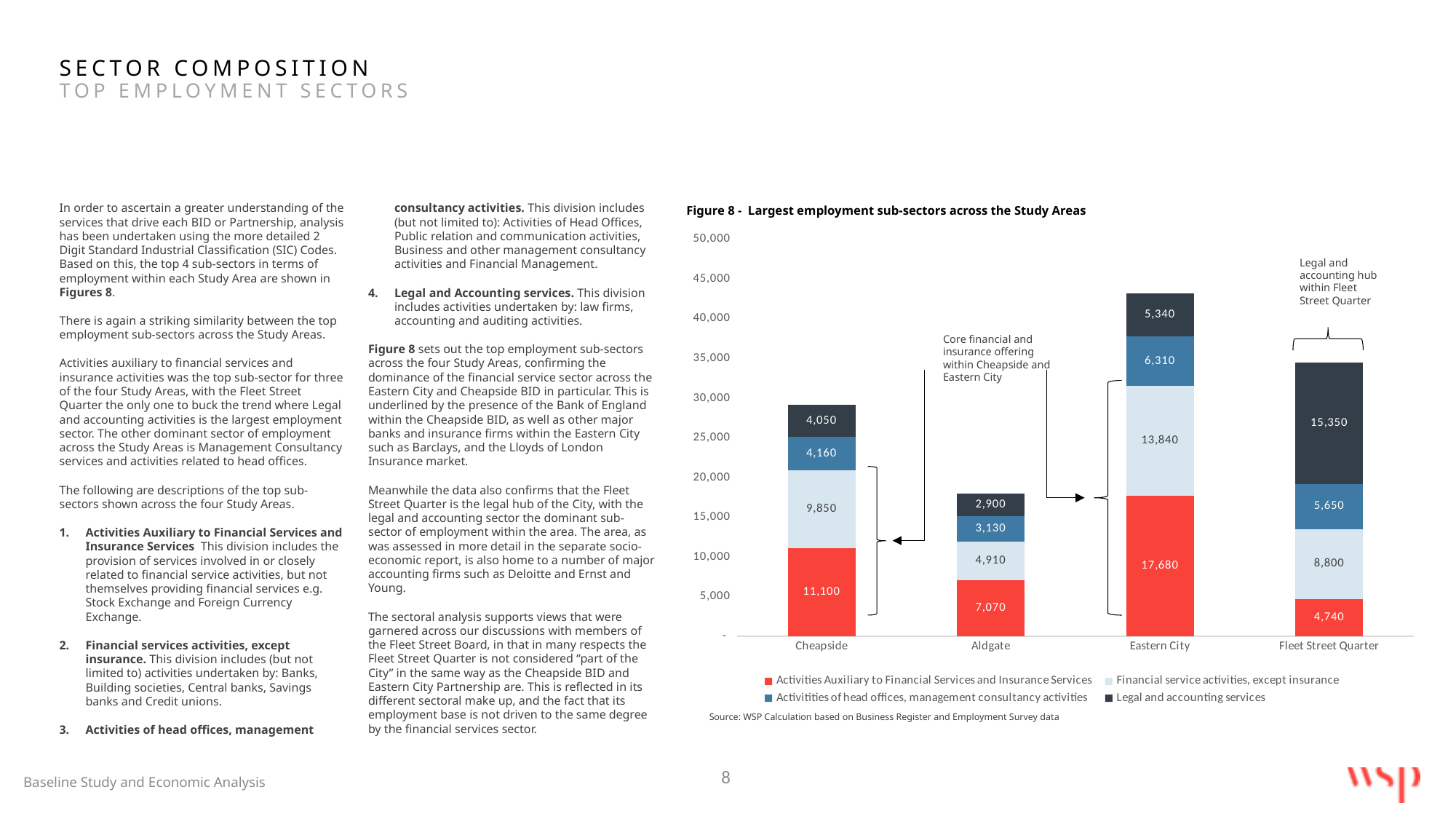
What is the difference between the Financial service activities, except insurance values for Eastern City and Cheapside? 3,990 How many series does the legend of Figure 8 list? 4 What is the value for Activities of head offices, management consultancy activities in Cheapside? 4,160 What is the value for Financial service activities, except insurance in Aldgate? 4,910 What is the total of the stacked bar for Aldgate? 18,010 What is the value for Legal and accounting services in Fleet Street Quarter? 15,350 Which Study Area has the highest value for Legal and accounting services? Fleet Street Quarter How many Study Areas are shown on the x axis of Figure 8? 4 What type of chart is Figure 8? Stacked bar chart What is the value for Activities Auxiliary to Financial Services and Insurance Services in Eastern City? 17,680 Which Study Area has the lowest value for Activities Auxiliary to Financial Services and Insurance Services? Fleet Street Quarter Which is larger: Activities of head offices, management consultancy activities in Eastern City or in Fleet Street Quarter? Eastern City